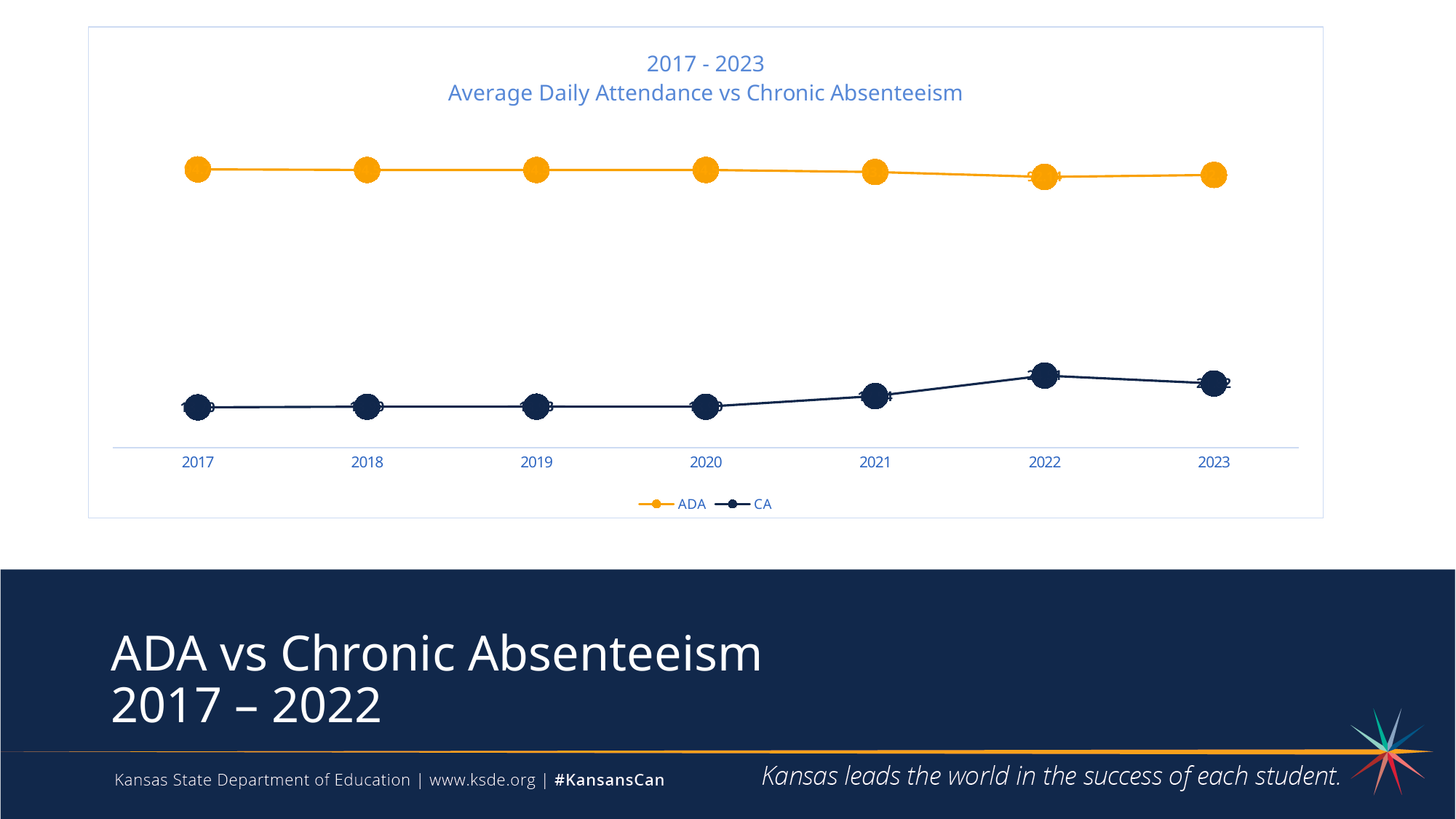
Which series is plotted in orange? ADA Which series has the higher value in 2020, ADA or CA? ADA How many years are plotted along the x axis? 7 Does the CA series rise or fall from 2022 to 2023? Fall Which series stays higher than the other across all years shown? ADA Is the CA value in 2021 higher or lower than the CA value in 2019? Higher What is the first year shown on the x axis? 2017 What is the title of the chart? 2017 - 2023 Average Daily Attendance vs Chronic Absenteeism How many series does the legend list? 2 What kind of chart is shown on the slide? Line chart Does the CA series rise or fall from 2020 to 2022? Rise In which year is the CA series at its highest? 2022